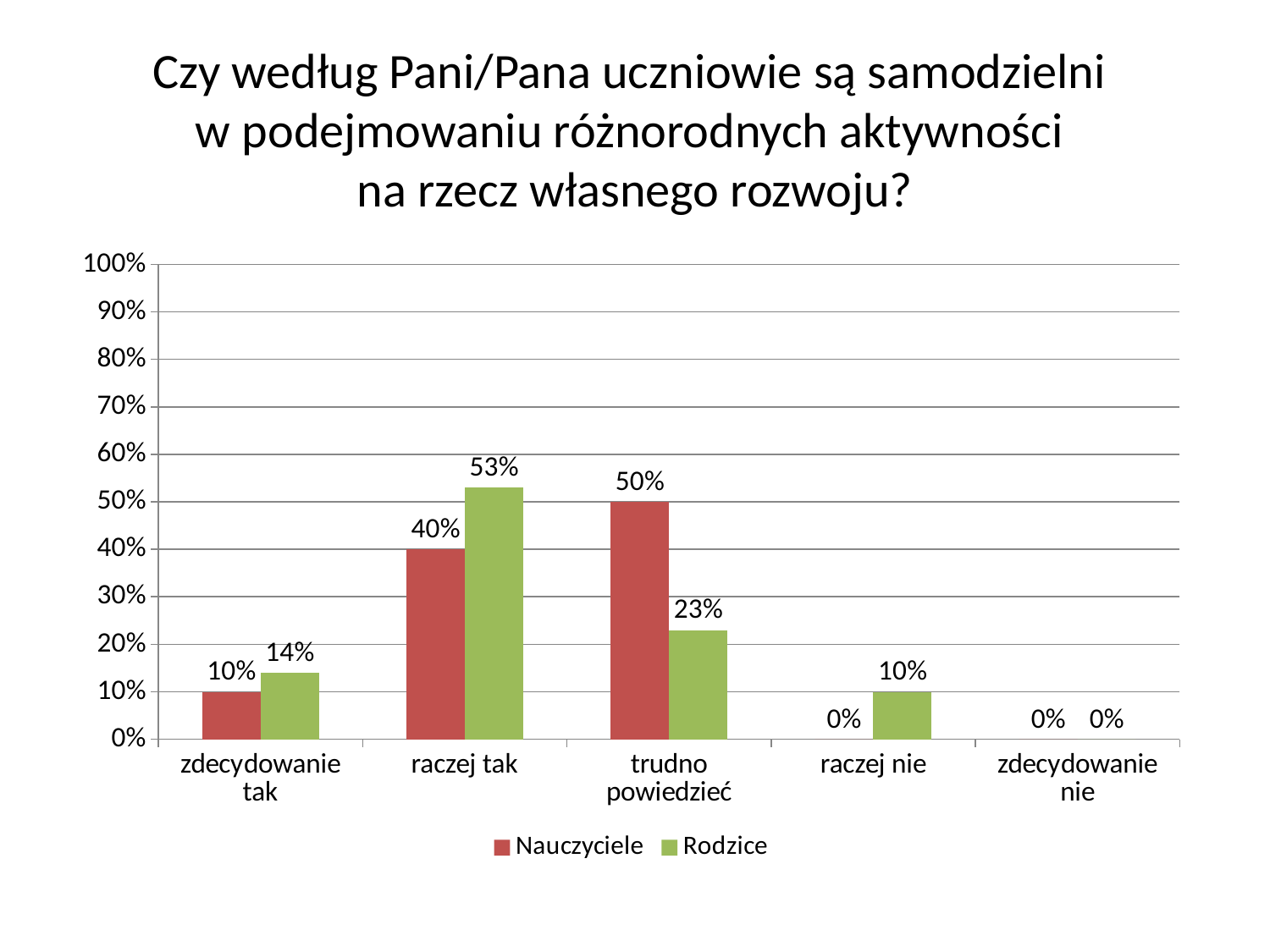
Which category has the highest value for the Rodzice series? raczej tak What is the value for Rodzice in the 'raczej nie' category? 10% How many categories are shown on the x axis? 5 How many series does the legend list? 2 What is the difference between the Nauczyciele and Rodzice values in the 'trudno powiedzieć' category? 27% What is the value for Nauczyciele in the 'raczej tak' category? 40% What kind of chart is shown on the slide? bar chart In the 'zdecydowanie tak' category, which series has the larger value, Nauczyciele or Rodzice? Rodzice Which colour represents the Nauczyciele series? red What is the difference between the Rodzice and Nauczyciele values in the 'raczej tak' category? 13% What is the value for Rodzice in the 'trudno powiedzieć' category? 23% Which category has the highest value for the Nauczyciele series? trudno powiedzieć